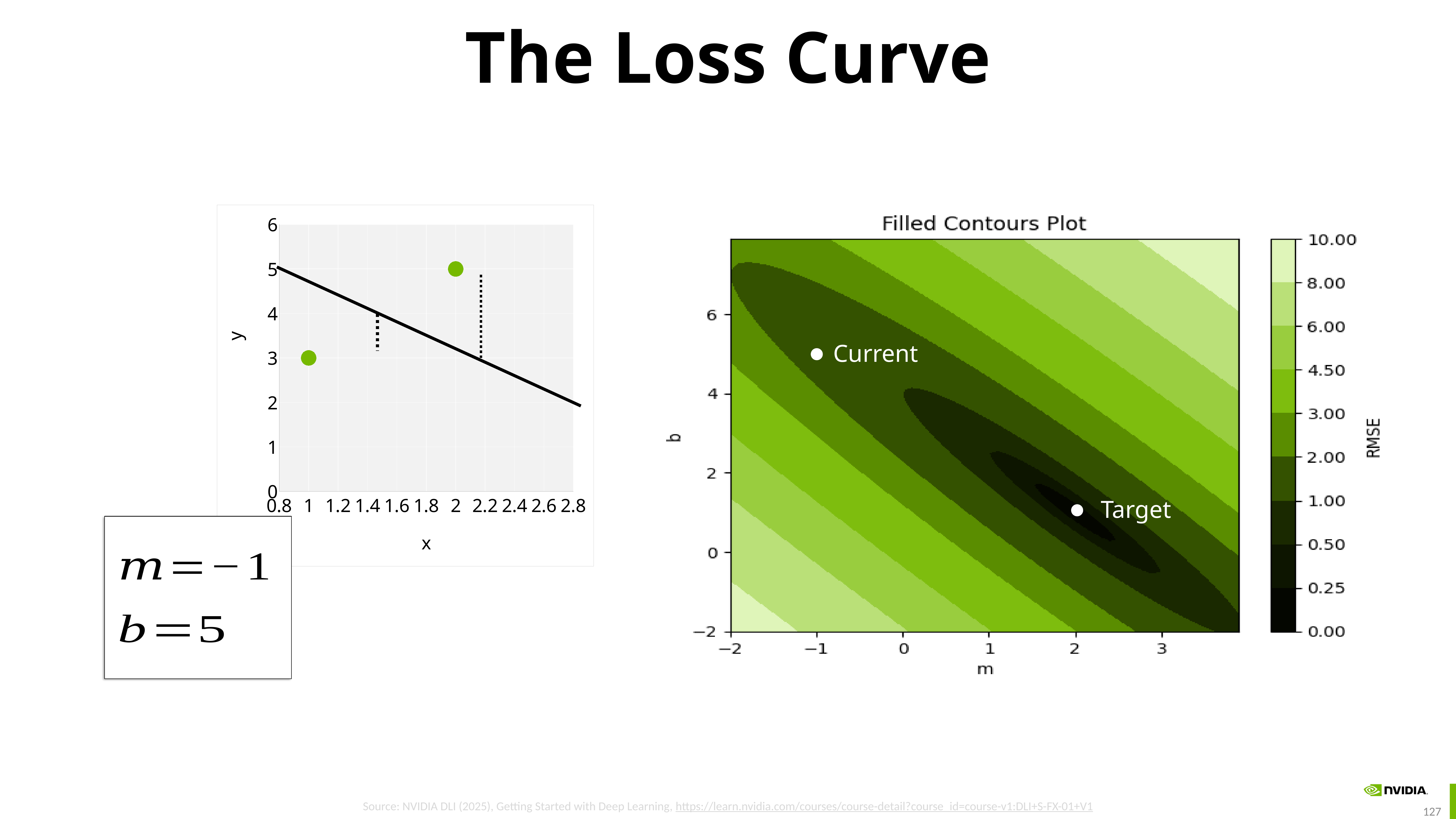
On the left scatter chart, what is the difference in y between the point at x = 2 and the point at x = 1? 2 On the Filled Contours Plot, which labelled point has the higher b value, Current or Target? Current On the Filled Contours Plot, what is the m value of the point labelled Current? -1 On the Filled Contours Plot, what is the m value of the point labelled Target? 2 On the Filled Contours Plot, what quantity does the colour bar represent? RMSE What is the title of the chart on the right? Filled Contours Plot On the left scatter chart, how many green data points are plotted? 2 On the left scatter chart, what is the y value of the data point at x = 1? 3 On the Filled Contours Plot, what is the b value of the point labelled Current? 5 On the left scatter chart, what is the y value of the data point at x = 2? 5 On the left scatter chart, which data point has the higher y value, the one at x = 1 or the one at x = 2? x = 2